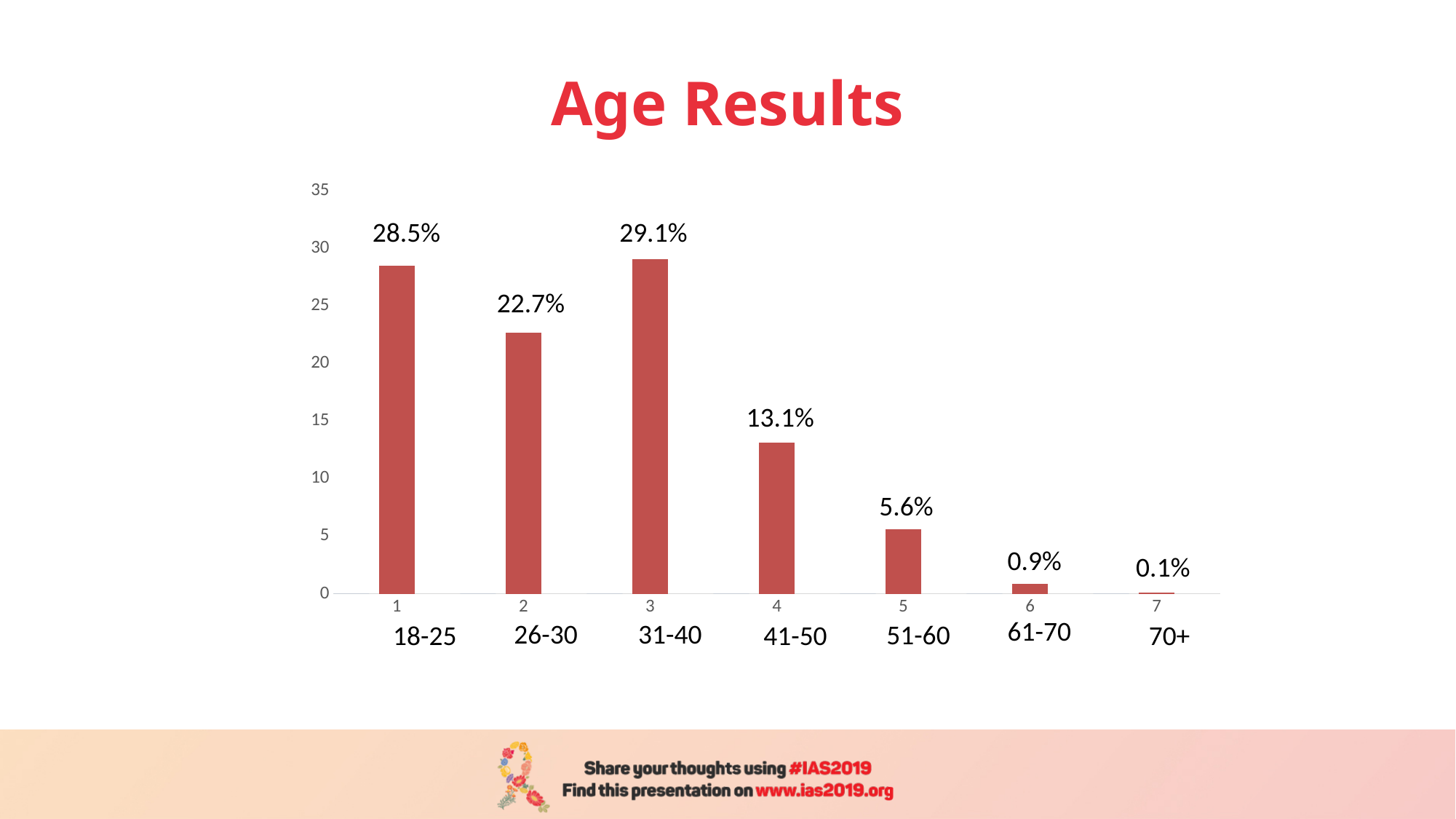
What is the value for the 70+ age group? 0.1% What kind of chart is shown on the slide? bar chart Which age group has the highest value? 31-40 How many age groups are shown in the chart? 7 What is the value for the 41-50 age group? 13.1% Which age group has the lowest value? 70+ What is the difference between the values for 51-60 and 61-70? 4.7% What is the value for the 18-25 age group? 28.5% What is the title of the chart? Age Results What is the difference between the values for 31-40 and 26-30? 6.4% Is the value for 41-50 greater or less than 15? less Which is larger, the value for 18-25 or the value for 26-30? 18-25